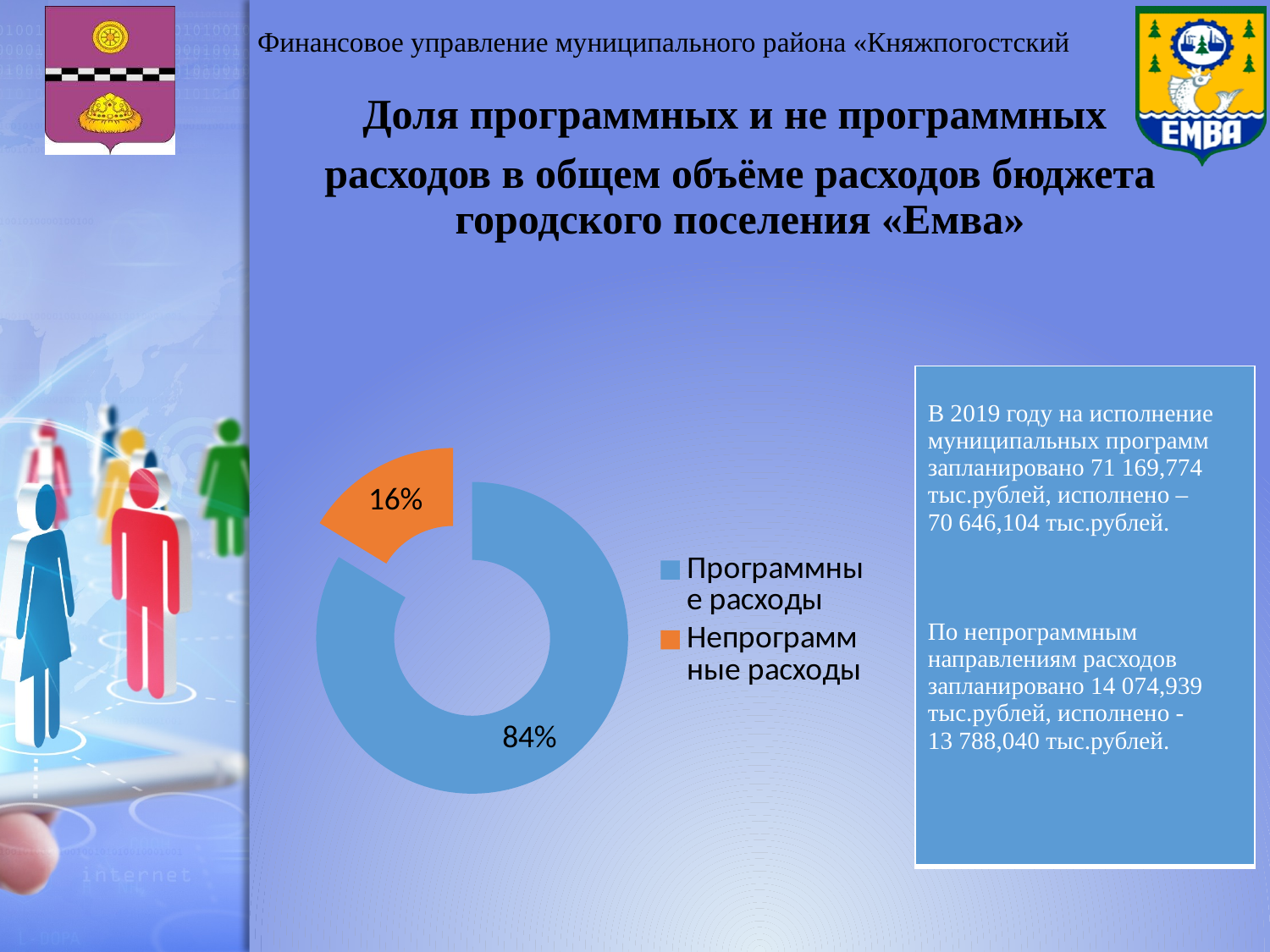
What is the total of the two percentages shown on the chart? 100% Which category has the smallest share of the chart? Непрограммные расходы Which is larger: the share for Программные расходы or the share for Непрограммные расходы? Программные расходы How many slices does the chart have? 2 How many entries does the chart legend list? 2 Which category has the largest share of the chart? Программные расходы What is the difference in percentage points between Программные расходы and Непрограммные расходы? 68 What share of the chart is labelled for Непрограммные расходы? 16% What kind of chart is shown on the slide? Doughnut (pie) chart What colour is the slice for Программные расходы? Blue What share of the chart is labelled for Программные расходы? 84% What colour is the slice for Непрограммные расходы? Orange